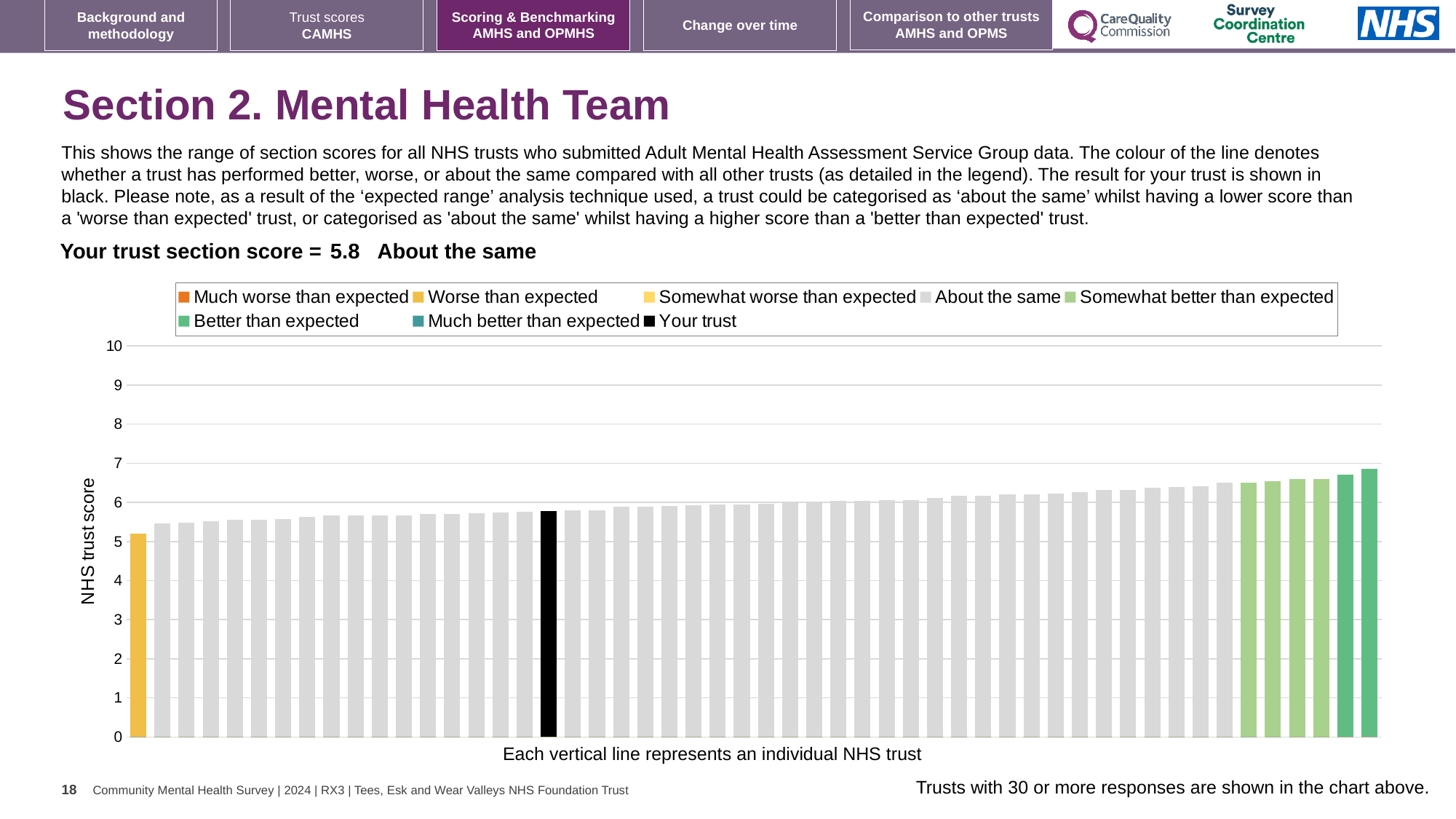
What is the label on the vertical axis of the chart? NHS trust score How many entries does the chart legend list? 8 Which category is your trust placed in for this section? About the same Is the value of the rightmost bar greater or less than 7? less Is the value of the leftmost (lowest) bar greater or less than 6? less How many bars are coloured yellow (Worse than expected)? 1 Do the bar values rise or fall from left to right along the x axis? rise What colour is the bar representing your trust? black What kind of chart is shown on the slide? bar chart Is your trust's section score greater or less than 6? less What is your trust's section score for Mental Health Team? 5.8